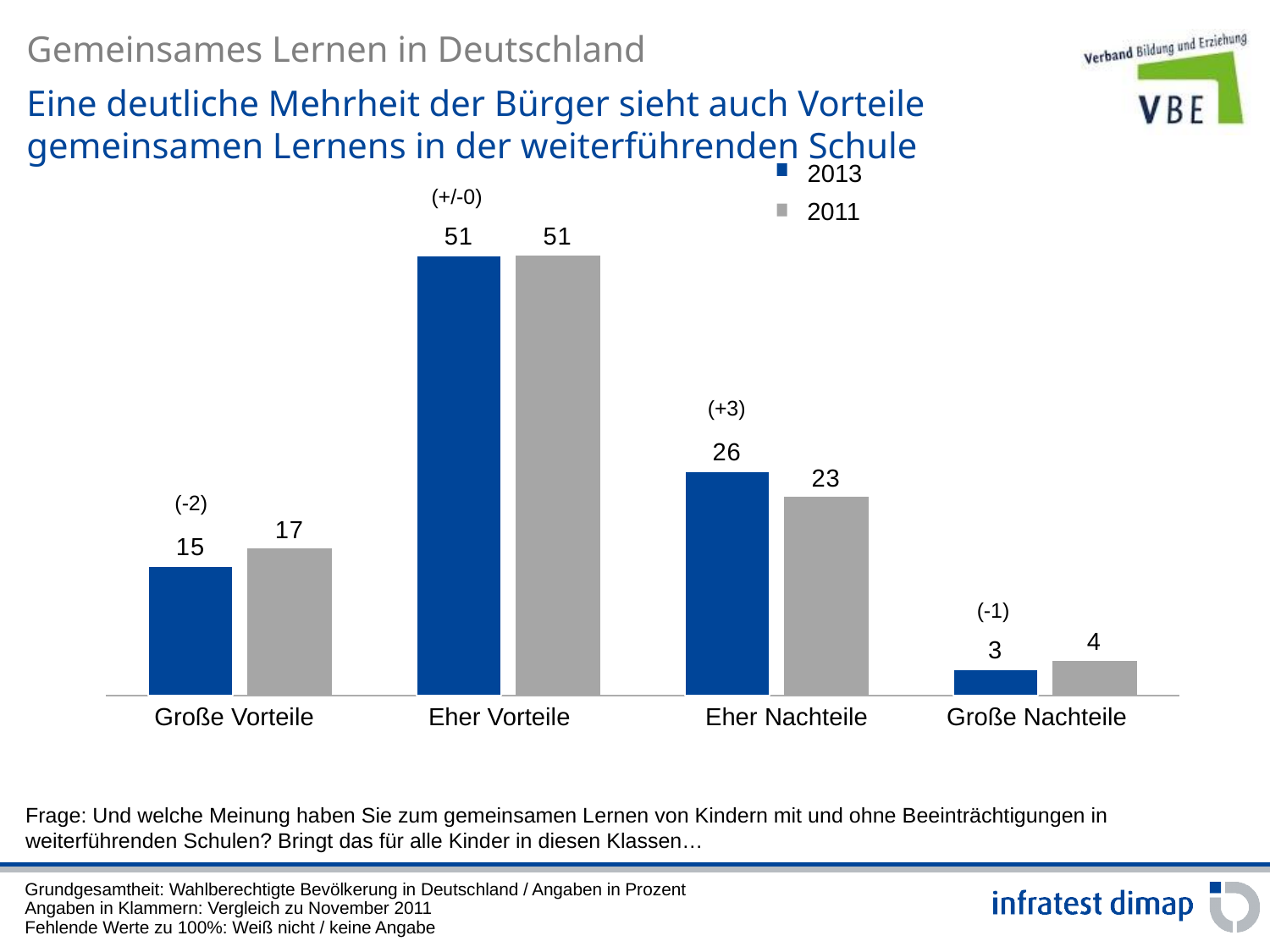
How many categories are shown on the x axis? 4 How many series does the legend list? 2 What change compared to November 2011 is shown in parentheses above Eher Nachteile? (+3) Which category has the highest 2013 value? Eher Vorteile Which category has the lowest 2011 value? Große Nachteile Which colour represents the 2013 series in the legend? Blue What is the 2013 value for Große Nachteile? 3 What is the difference between the 2013 and 2011 values for Eher Nachteile? 3 What is the 2013 value for Eher Vorteile? 51 Which is larger for Große Vorteile, the 2013 value or the 2011 value? 2011 What kind of chart is shown on the slide? Bar chart What is the 2011 value for Große Vorteile? 17